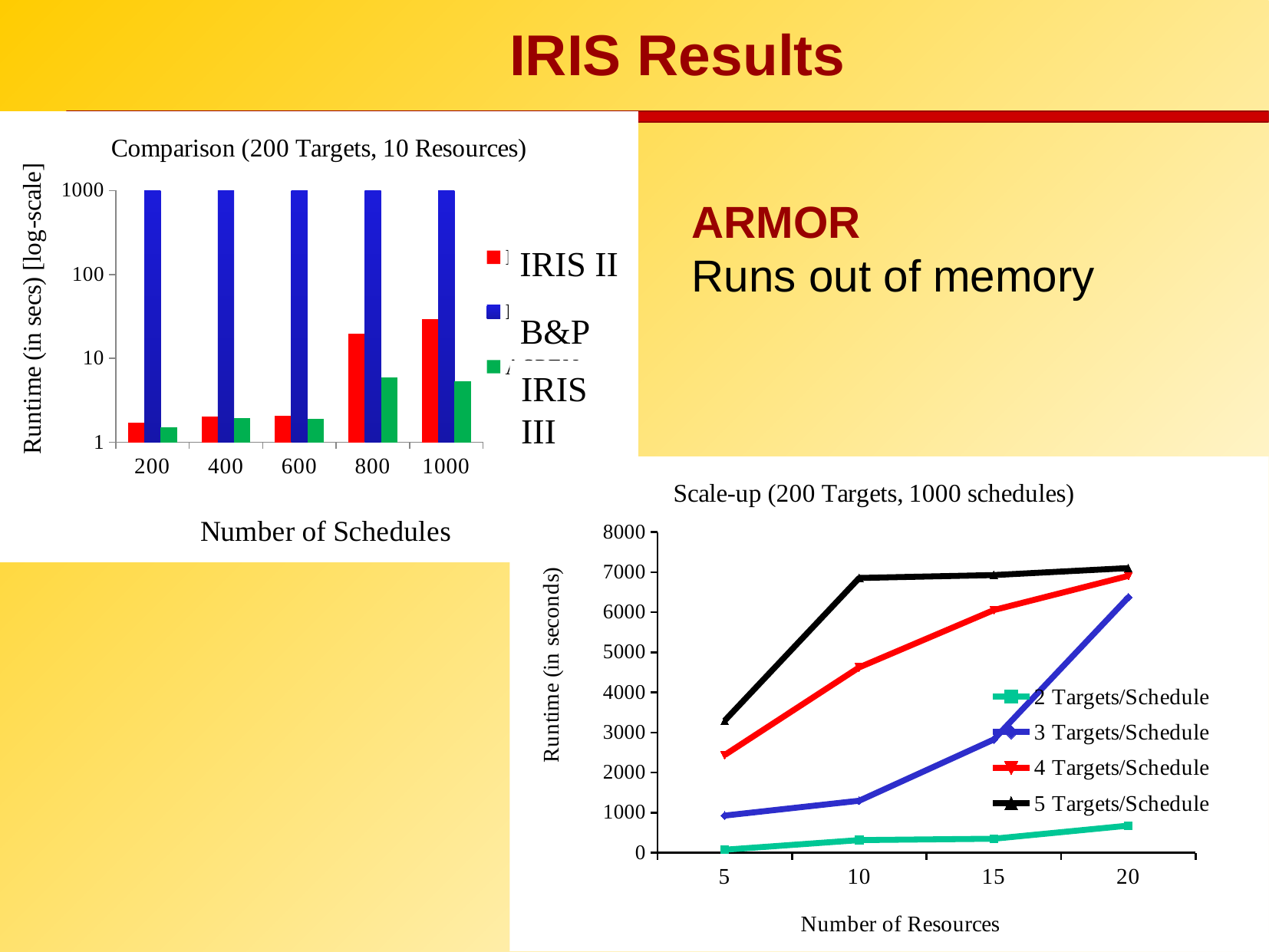
How many points on the x axis does the 'Scale-up (200 Targets, 1000 schedules)' chart show? 4 What kind of chart is the 'Comparison (200 Targets, 10 Resources)' chart? bar chart What kind of chart is the 'Scale-up (200 Targets, 1000 schedules)' chart? line chart How many series does the legend of the 'Scale-up (200 Targets, 1000 schedules)' chart list? 4 In the 'Scale-up (200 Targets, 1000 schedules)' chart, which series has the highest runtime at 10 resources? 5 Targets/Schedule In the 'Comparison (200 Targets, 10 Resources)' chart, which series has the highest runtime at 1000 schedules? B&P In the 'Comparison (200 Targets, 10 Resources)' chart, is the IRIS III runtime at 400 schedules greater or less than 10? less In the 'Scale-up (200 Targets, 1000 schedules)' chart, is the runtime for 3 Targets/Schedule at 20 resources greater or less than 5000? greater In the 'Scale-up (200 Targets, 1000 schedules)' chart, does the runtime for 4 Targets/Schedule rise or fall as the number of resources increases? rise How many series does the legend of the 'Comparison (200 Targets, 10 Resources)' chart list? 3 How many categories are shown on the x axis of the 'Comparison (200 Targets, 10 Resources)' chart? 5 In the 'Comparison (200 Targets, 10 Resources)' chart, is the IRIS II runtime at 800 schedules greater or less than 10? greater